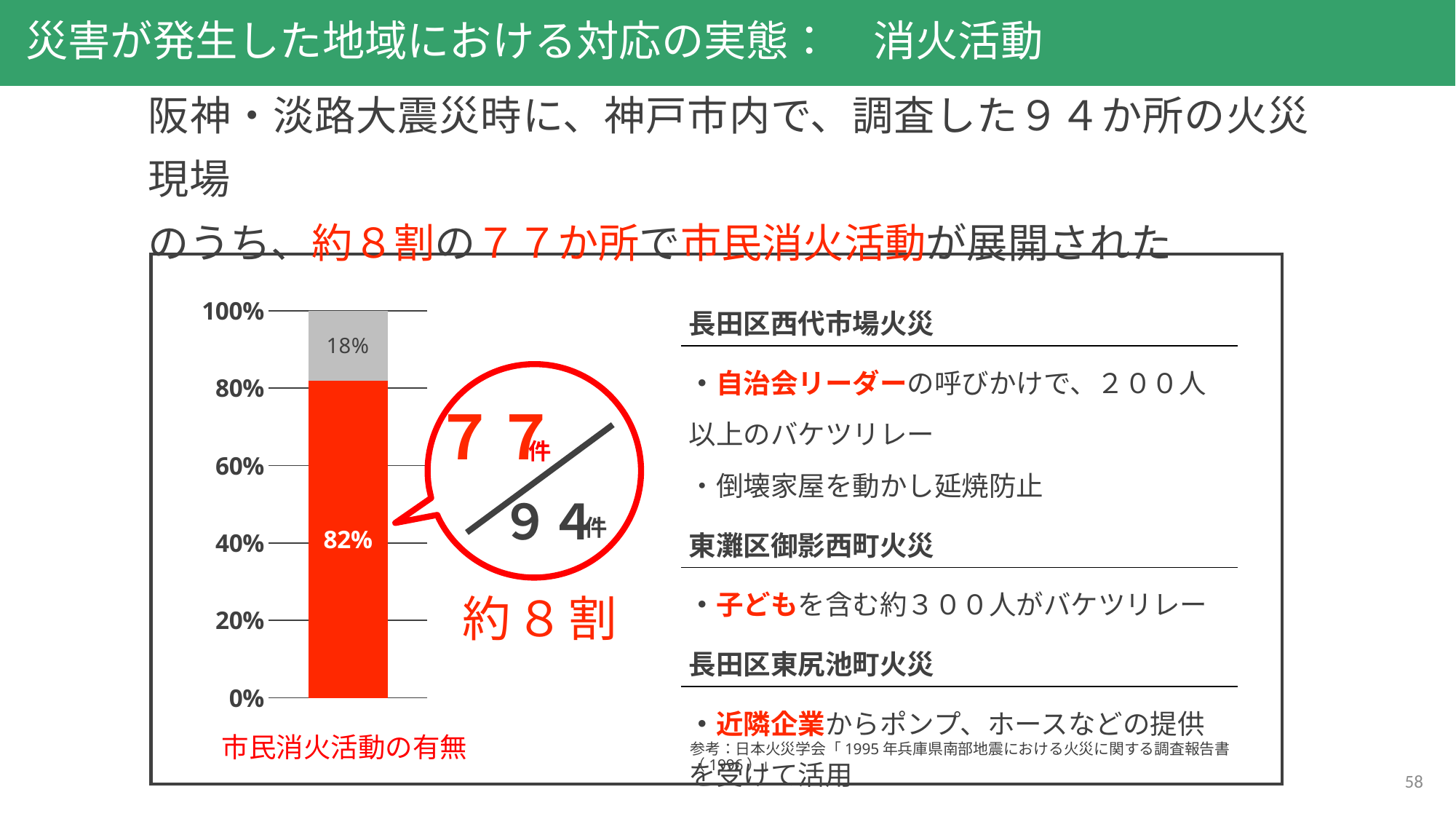
Is the top of the red segment greater or less than 80% on the axis? greater What is the total of the two segments of the stacked bar? 100% What kind of chart is shown on the slide? bar chart What value is printed on the gray segment of the bar? 18% Is the gray segment's value greater or less than 20%? less What value is printed on the red segment of the bar? 82% What is the label written below the bar chart? 市民消火活動の有無 What fraction is shown in the red circle callout next to the bar? 77件 / 94件 What is the highest value shown on the vertical axis? 100% Which segment of the bar is larger, the red one or the gray one? the red one How many bars are plotted in the chart? 1 What is the difference in percentage points between the red segment (82%) and the gray segment (18%)? 64